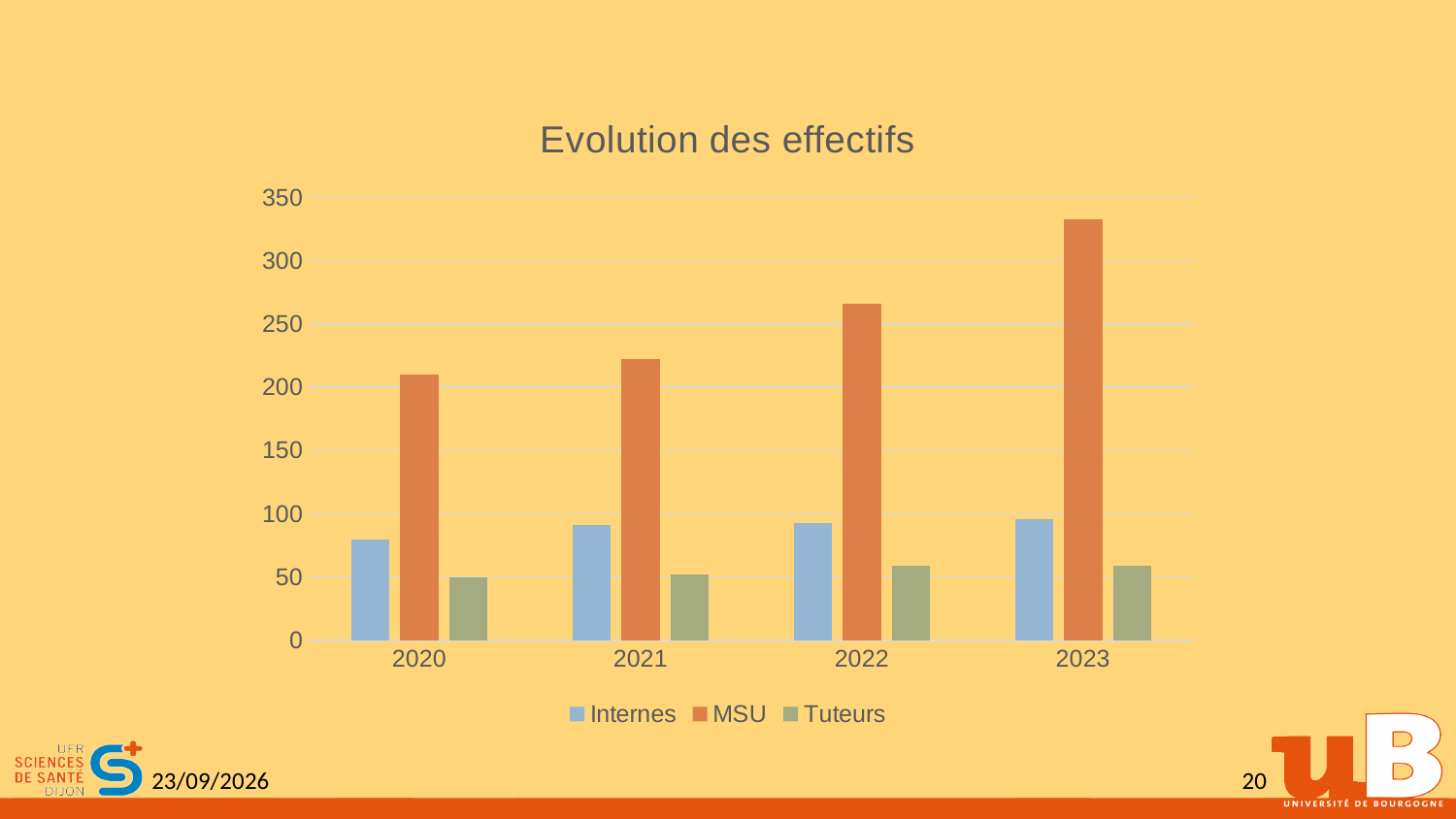
Which series is shown in orange? MSU In which year is the MSU bar the lowest? 2020 In which year is the MSU bar the highest? 2023 How many series does the legend list? 3 How many years are shown on the x axis? 4 Which is larger, the Internes value for 2020 or the Internes value for 2021? 2021 Is the MSU value for 2022 greater or less than 250? greater What kind of chart is shown on the slide? bar chart Is the Internes value for 2020 greater or less than 100? less What is the title of the chart? Evolution des effectifs Is the MSU value for 2023 greater or less than 300? greater Do the MSU values rise or fall from 2020 to 2023? rise